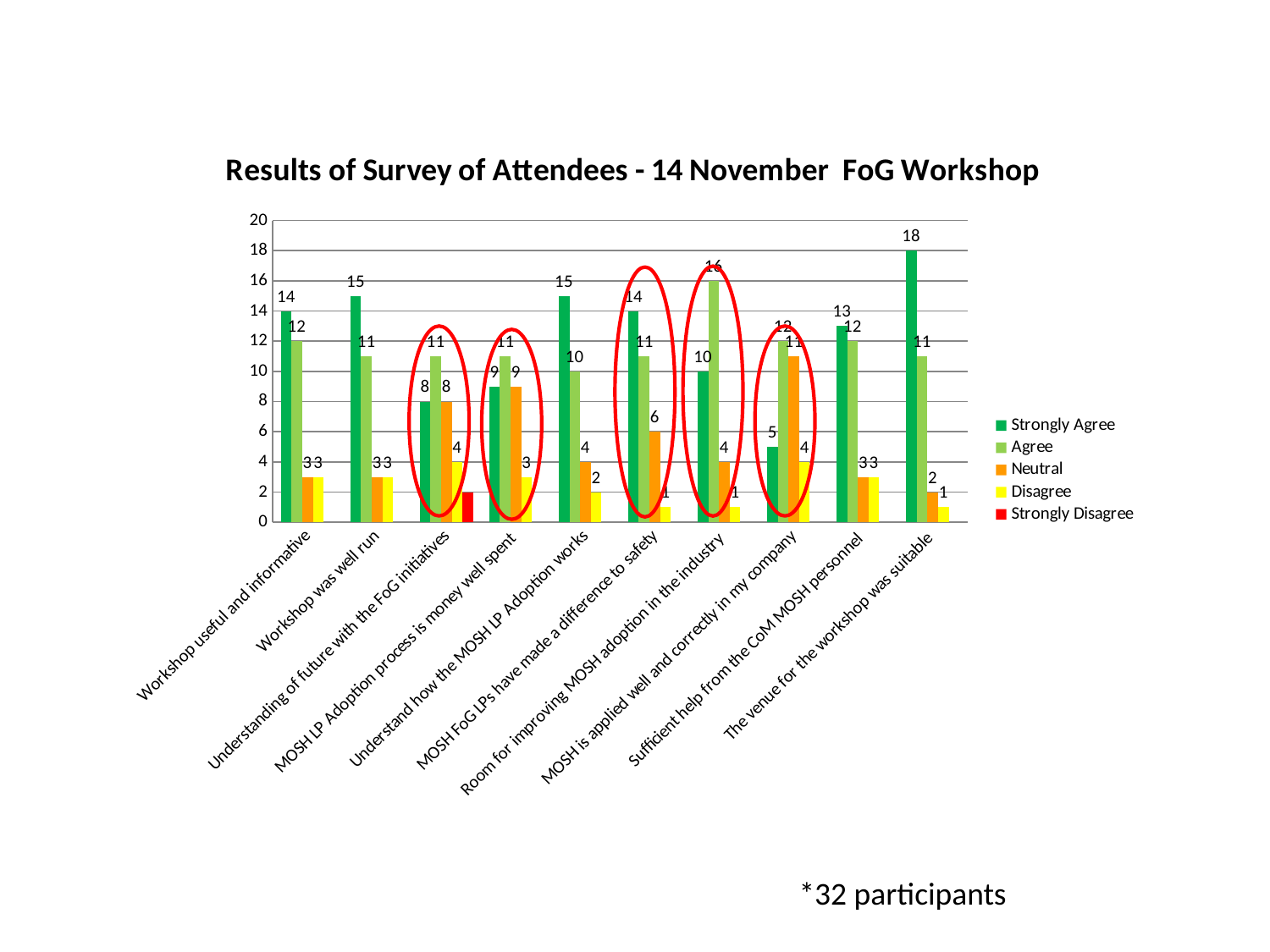
Which category has the highest Strongly Agree value? The venue for the workshop was suitable How many categories are shown on the x axis? 10 How many series does the legend list? 5 What is the Agree value for "Room for improving MOSH adoption in the industry"? 16 Which category has the lowest Strongly Agree value? MOSH is applied well and correctly in my company What is the Neutral value for "MOSH is applied well and correctly in my company"? 11 What kind of chart is shown on the slide? Bar chart What is the Strongly Agree value for "The venue for the workshop was suitable"? 18 What is the difference between the Strongly Agree and Agree values for "Workshop useful and informative"? 2 For "Room for improving MOSH adoption in the industry", which is larger: Strongly Agree or Agree? Agree Which colour represents the Neutral series in the legend? Orange What is the title of the chart? Results of Survey of Attendees - 14 November FoG Workshop